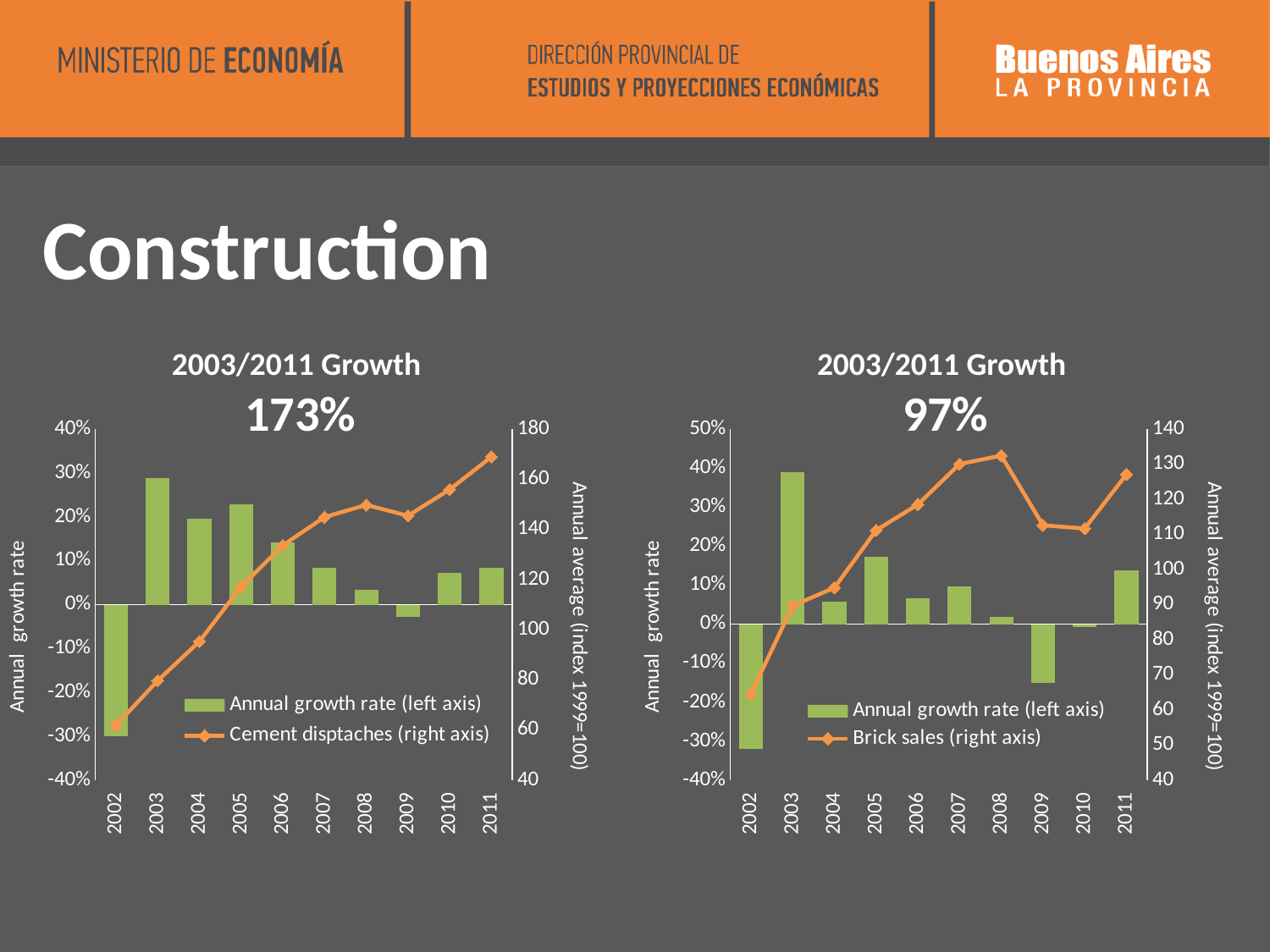
On the left chart (cement dispatches), what growth figure is printed under the title '2003/2011 Growth'? 173% On the left chart (cement dispatches), is the cement dispatches index value for 2011 greater or less than 160? greater On the right chart (brick sales), is the brick sales index value for 2008 greater or less than 120? greater On the left chart (cement dispatches), which year has the lowest annual growth rate bar? 2002 On the right chart (brick sales), is the brick sales index value for 2002 greater or less than 80? less On the right chart (brick sales), which year has the highest annual growth rate bar? 2003 On the right chart (brick sales), which year has the lowest annual growth rate bar? 2002 On the right chart (brick sales), what growth figure is printed under the title '2003/2011 Growth'? 97% On the left chart (cement dispatches), which year has the highest annual growth rate bar? 2003 On the left chart (cement dispatches), how many years are shown on the x axis? 10 On the left chart (cement dispatches), how many series does the legend list? 2